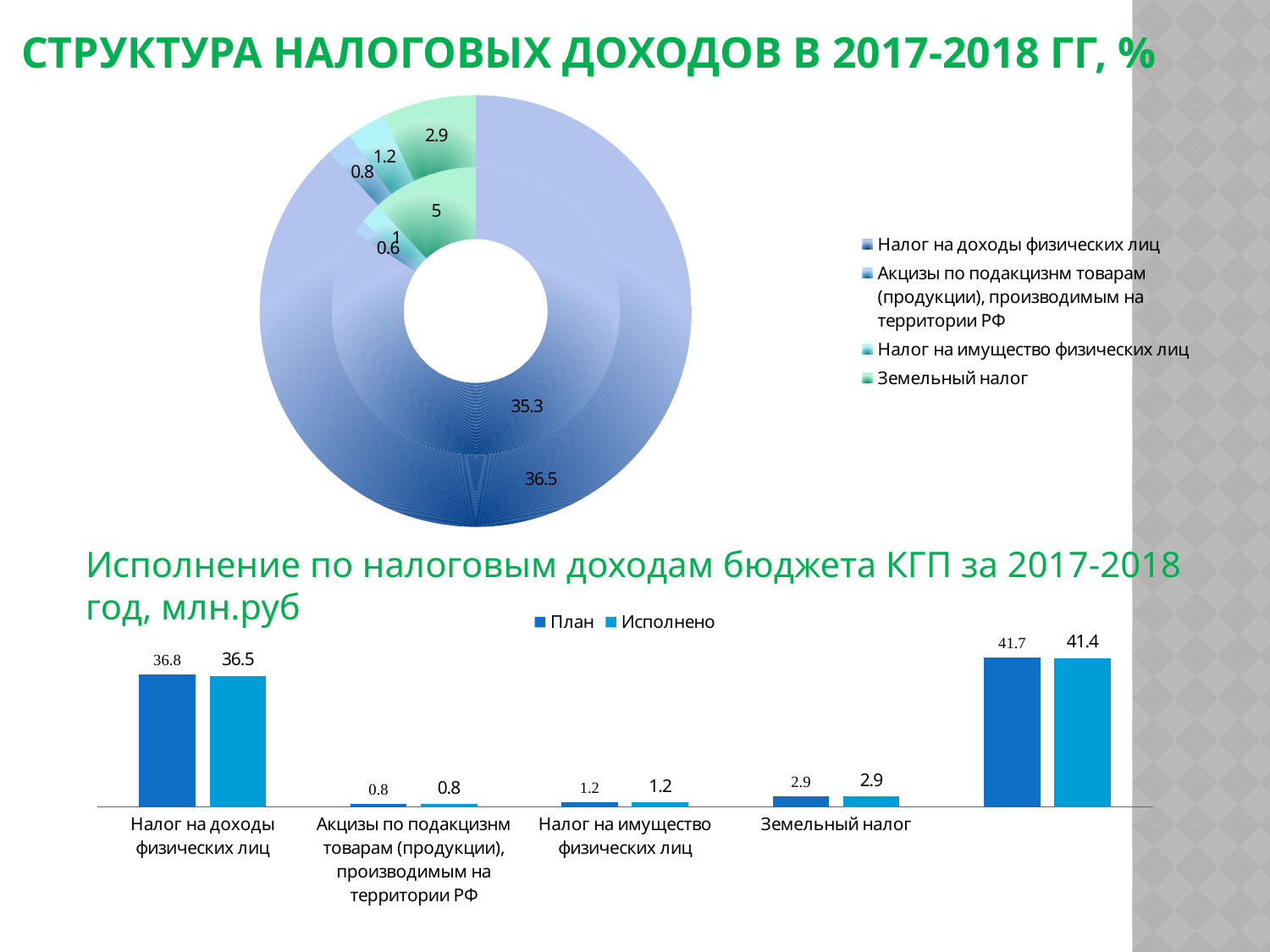
In the bottom bar chart, what is the Исполнено value for Налог на доходы физических лиц? 36.5 How many series does the legend of the bottom chart list? 2 In the bottom bar chart, what is the Исполнено value for Налог на имущество физических лиц? 1.2 In the bottom bar chart, which is larger for Налог на доходы физических лиц: План or Исполнено? План In the bottom bar chart, which of the labelled categories has the lowest values? Акцизы по подакцизнм товарам (продукции), производимым на территории РФ How many entries does the legend of the top doughnut chart list? 4 In the top doughnut chart, what is the largest value shown on the outer ring? 36.5 What kind of chart is the bottom chart? Bar chart In the bottom bar chart, what is the difference between the План and Исполнено values for Налог на доходы физических лиц? 0.3 In the bottom bar chart, what is the План value for Земельный налог? 2.9 What kind of chart is the top chart? Doughnut chart In the bottom bar chart, what is the План value for Налог на доходы физических лиц? 36.8